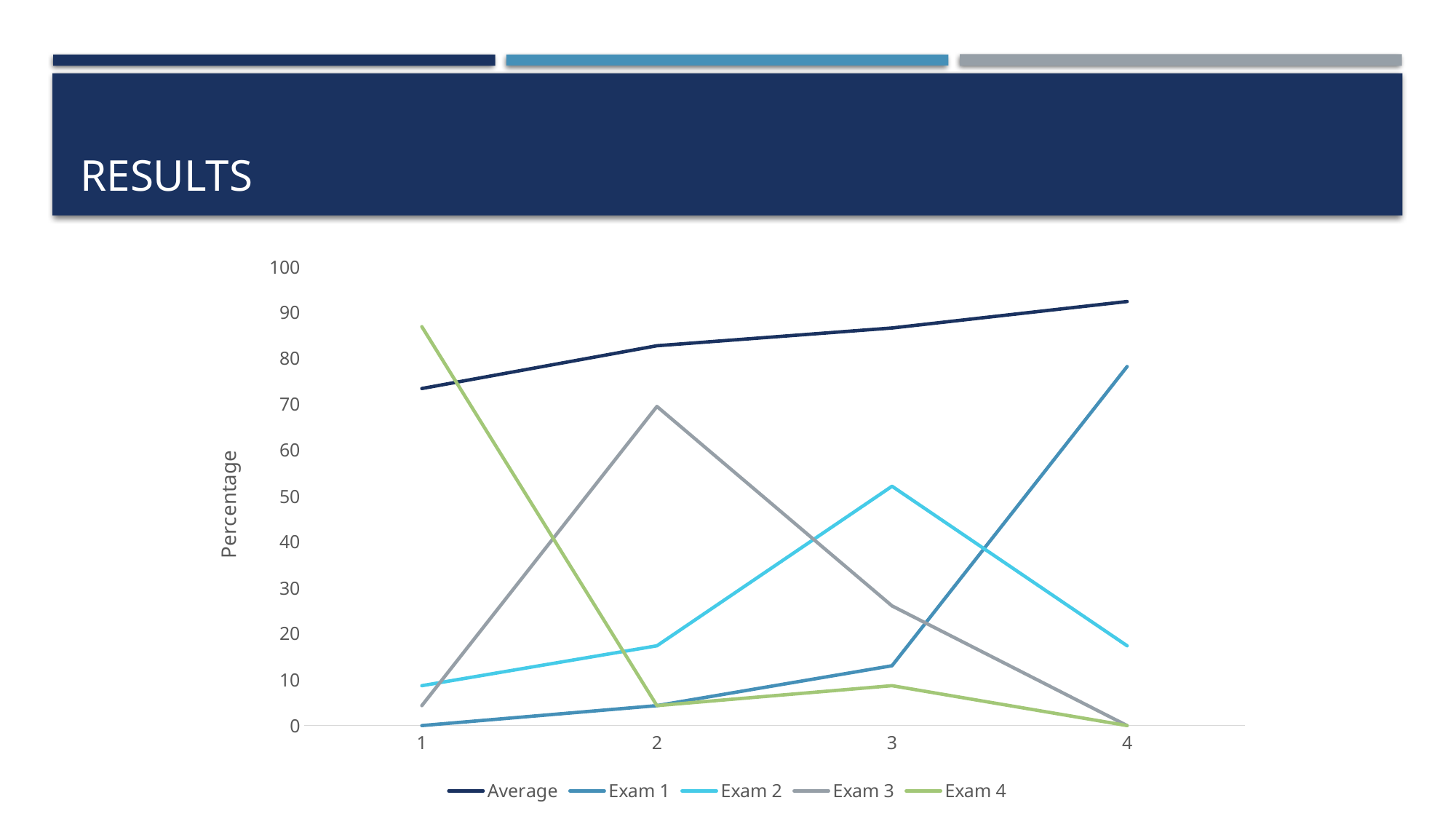
Is the value for Exam 3 at x = 2 greater or less than 60? greater What kind of chart is shown on the slide? line chart Is the value for Average at x = 4 greater or less than 90? greater Which series has the highest value at x = 3? Average At x = 1, which series has the higher value, Exam 4 or Exam 2? Exam 4 What is the value for Exam 4 at x = 4? 0 How many points are plotted along the x axis for each series? 4 What is the label of the y axis? Percentage How many series does the legend list? 5 Is the value for Exam 2 at x = 4 greater or less than 20? less What is the value for Exam 1 at x = 1? 0 Does the Average series rise or fall from x = 1 to x = 4? rise